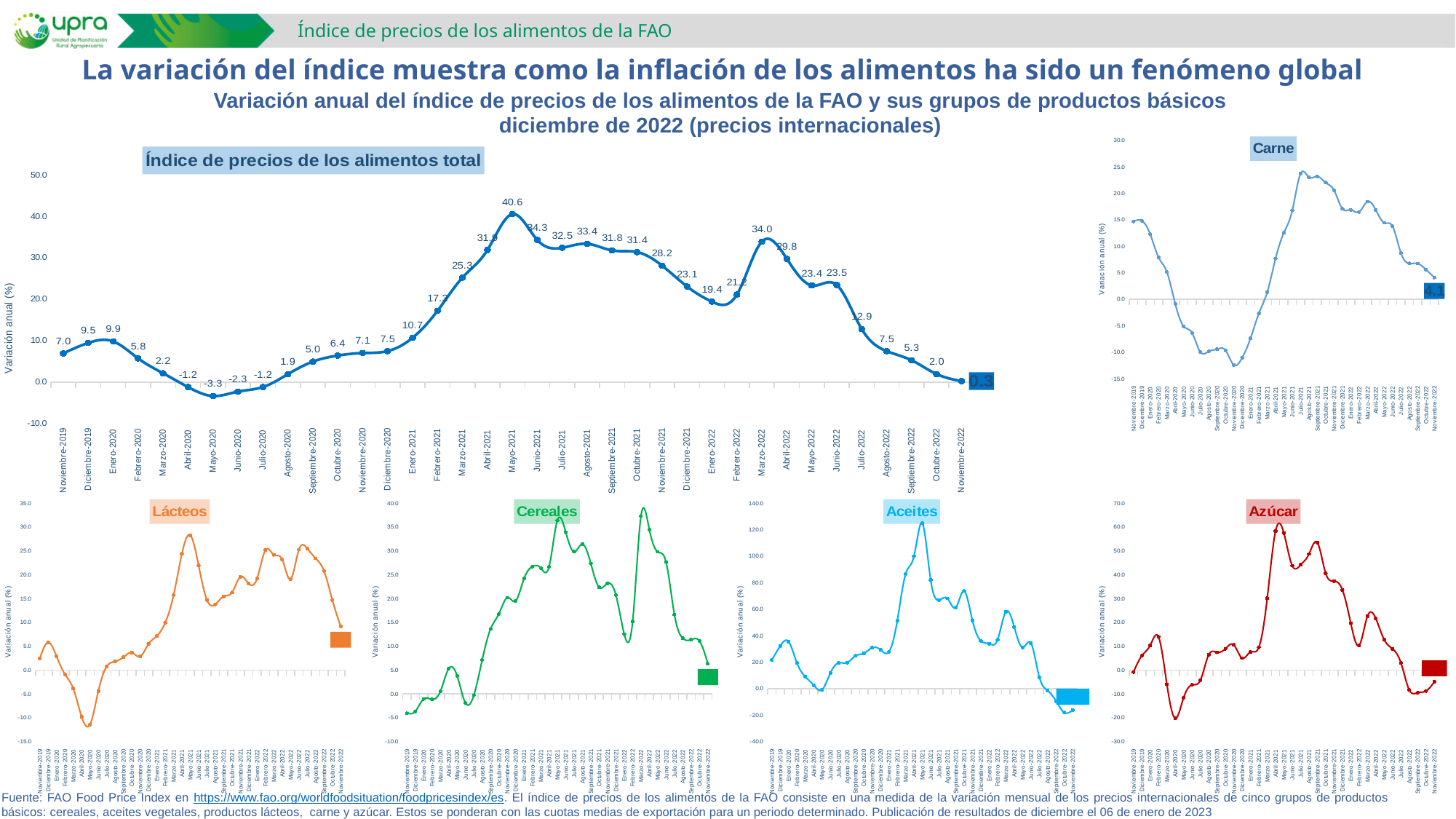
In the 'Índice de precios de los alimentos total' chart, what is the value for Marzo-2022? 34.0 In the 'Índice de precios de los alimentos total' chart, which month has the highest value? Mayo-2021 In the 'Índice de precios de los alimentos total' chart, which is larger: the value for Abril-2021 or Junio-2021? Junio-2021 In the 'Índice de precios de los alimentos total' chart, what is the value for Mayo-2021? 40.6 In the 'Aceites' chart, is the highest value greater or less than 100.0? greater In the 'Índice de precios de los alimentos total' chart, what is the value for Febrero-2021? 17.3 What kind of chart is the 'Índice de precios de los alimentos total' chart? Line chart In the 'Azúcar' chart, is the highest value greater or less than 50.0? greater In the 'Índice de precios de los alimentos total' chart, which month has the lowest value? Mayo-2020 In the 'Índice de precios de los alimentos total' chart, what is the difference between the values for Mayo-2021 and Marzo-2022? 6.6 In the 'Índice de precios de los alimentos total' chart, do the values rise or fall from Mayo-2021 to Enero-2022? Fall How many charts are shown on the slide? 6